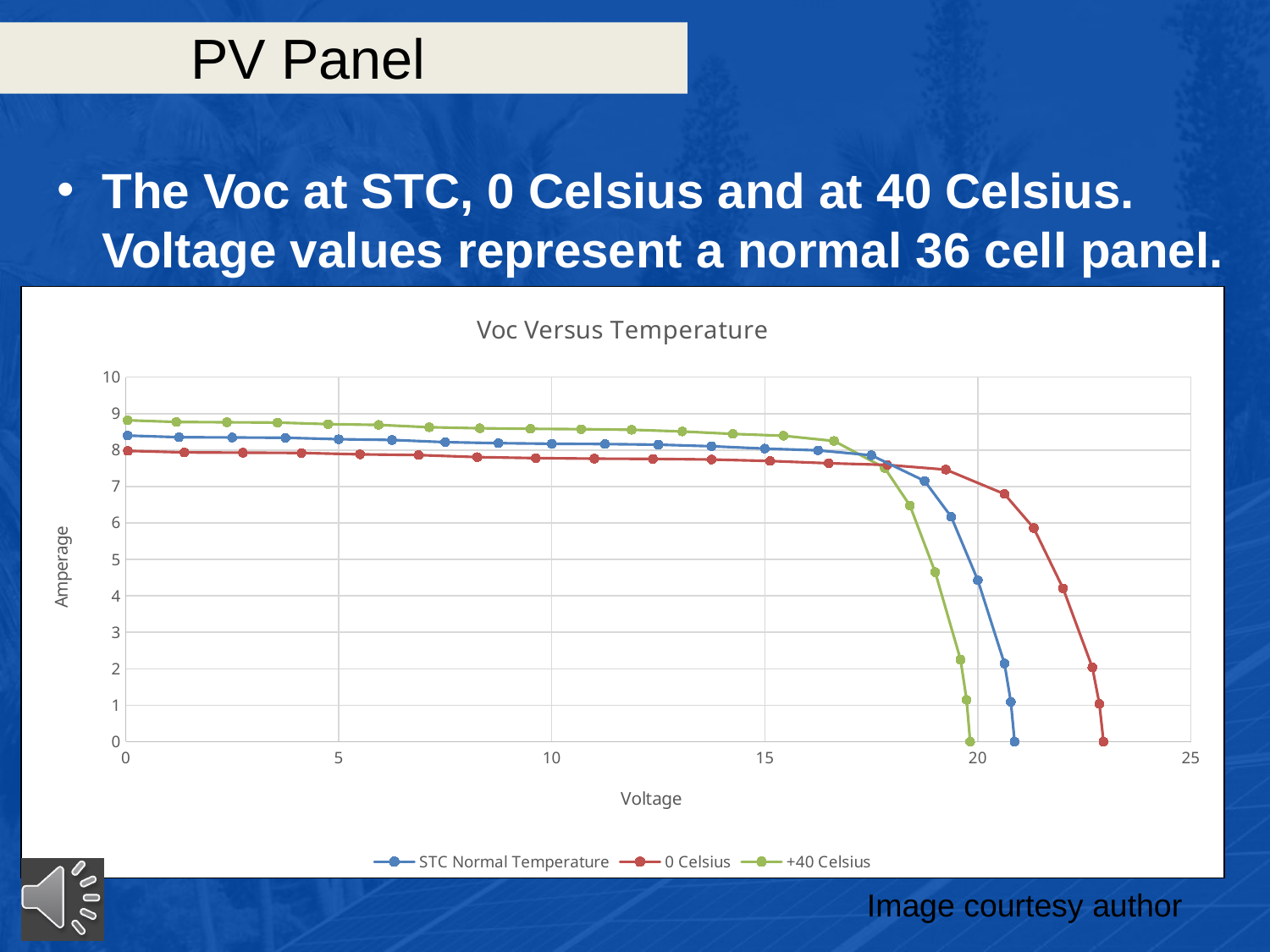
What is the maximum value shown on the Voltage axis? 25 Which series reaches zero amperage at the highest voltage? 0 Celsius At a voltage of 0, which series has the higher amperage, +40 Celsius or 0 Celsius? +40 Celsius Is the amperage of the +40 Celsius series at a voltage of 0 greater or less than 8? greater How many series does the legend of the chart list? 3 What is the title of the chart? Voc Versus Temperature Is the voltage at which the 0 Celsius series drops to zero amperage greater or less than 20? greater Which series reaches zero amperage at the lowest voltage? +40 Celsius What are the labels of the x axis and y axis of the chart? Voltage (x axis) and Amperage (y axis) As voltage increases along the x axis, does the amperage of each series rise or fall? fall Is the amperage of the 0 Celsius series at a voltage of 0 greater or less than 9? less What kind of chart is shown on the slide? Line chart